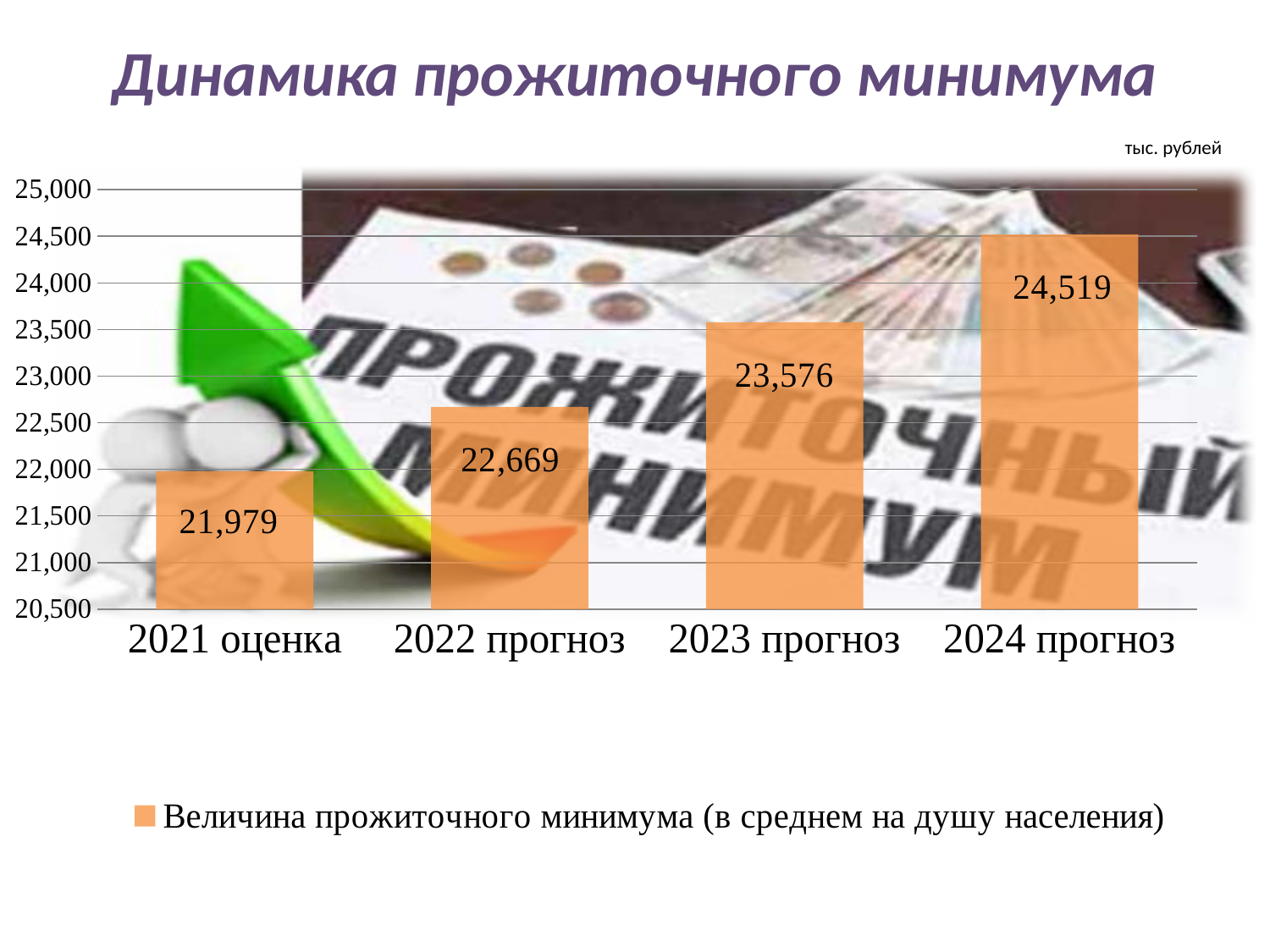
What is the value for 2024 прогноз? 24,519 Which category has the highest value? 2024 прогноз What is the value for 2021 оценка? 21,979 What is the value for 2023 прогноз? 23,576 How many categories are shown on the x axis? 4 Which is larger, the value for 2022 прогноз or the value for 2023 прогноз? 2023 прогноз What kind of chart is shown on the slide? bar chart Which category has the lowest value? 2021 оценка What is the difference between the values for 2024 прогноз and 2021 оценка? 2,540 What is the difference between the values for 2022 прогноз and 2021 оценка? 690 Do the values rise or fall from 2021 оценка to 2024 прогноз? rise Is the value for 2023 прогноз greater or less than 23,000? greater